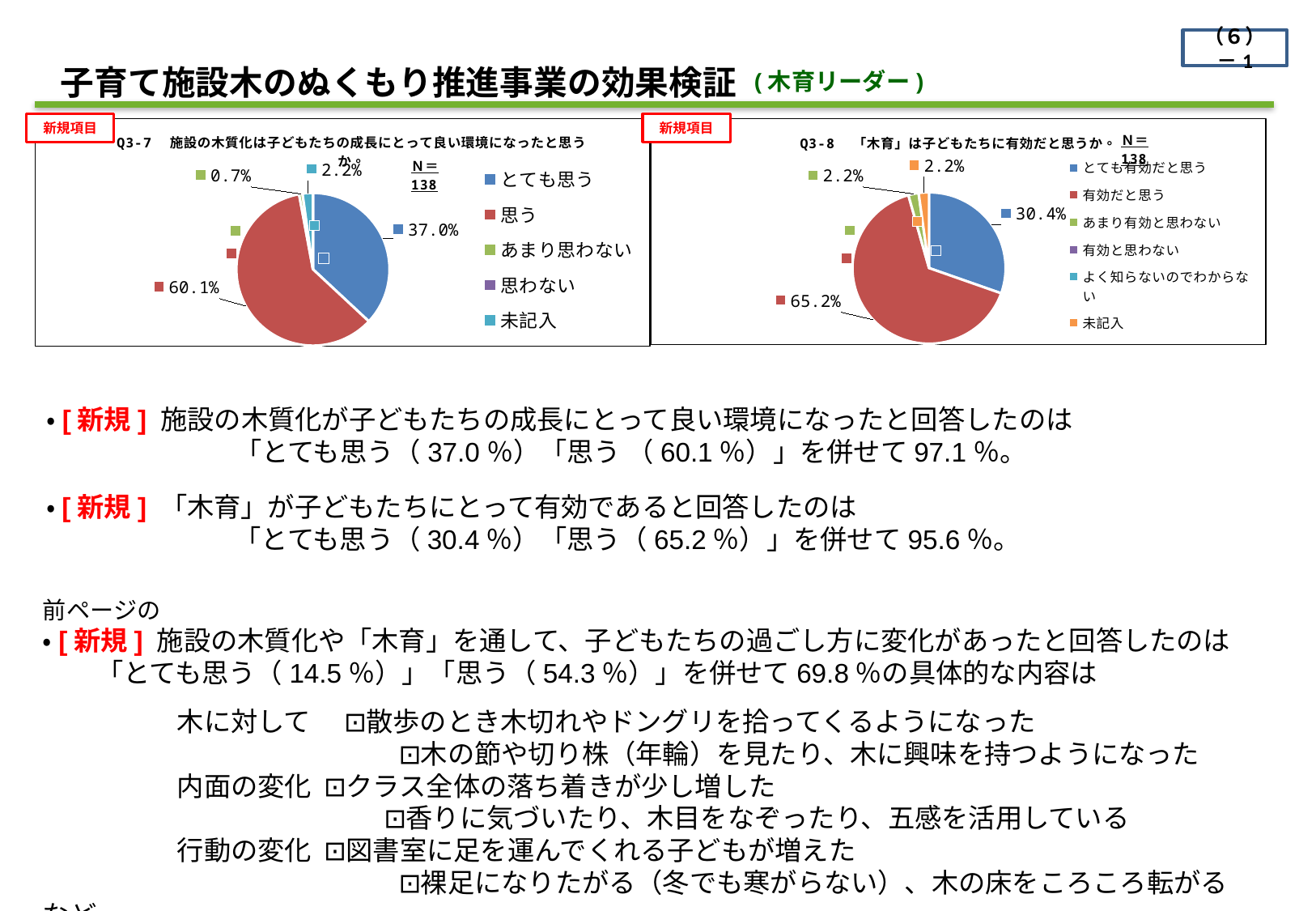
In the right pie chart (Q3-8), which category has the largest share? 有効だと思う In the right pie chart (Q3-8), which is larger: the share for 「とても有効だと思う」 or for 「有効だと思う」? 有効だと思う In the right pie chart (Q3-8), what percentage of respondents answered 「有効だと思う」? 65.2% What type of chart is used for Q3-7 on the left? Pie chart In the left pie chart (Q3-7), which category has the largest share? 思う In the right pie chart (Q3-8), what percentage of respondents answered 「とても有効だと思う」? 30.4% In the left pie chart (Q3-7), what is the difference between the shares for 「思う」 and 「とても思う」? 23.1% In the left pie chart (Q3-7), what percentage of respondents answered 「とても思う」? 37.0% In the left pie chart (Q3-7), what percentage is shown for 「あまり思わない」? 0.7% How many entries does the legend of the right pie chart (Q3-8) list? 6 How many entries does the legend of the left pie chart (Q3-7) list? 5 In the left pie chart (Q3-7), what percentage of respondents answered 「思う」? 60.1%